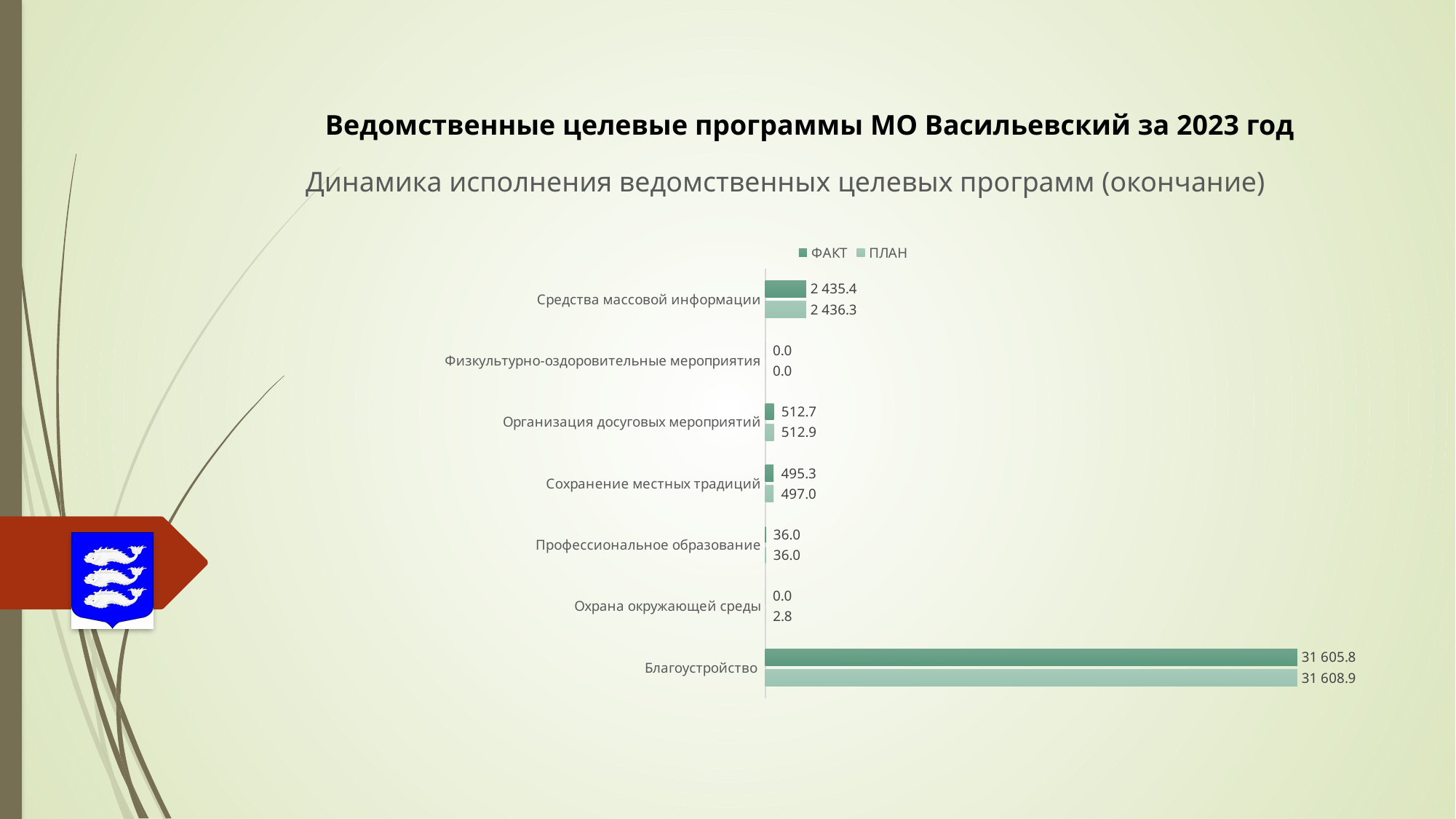
Which category has the highest ФАКТ value? Благоустройство How many categories are shown in the chart? 7 What is the ПЛАН value for Благоустройство? 31 608.9 What is the difference between the ПЛАН and ФАКТ values for Сохранение местных традиций? 1.7 What are the two series named in the legend? ФАКТ and ПЛАН What is the ФАКТ value for Средства массовой информации? 2 435.4 What is the difference between the ПЛАН and ФАКТ values for Благоустройство? 3.1 Which has the larger ФАКТ value: Организация досуговых мероприятий or Сохранение местных традиций? Организация досуговых мероприятий What kind of chart is shown on the slide? Bar chart How many series does the legend list? 2 What is the ПЛАН value for Охрана окружающей среды? 2.8 What is the ФАКТ value for Сохранение местных традиций? 495.3